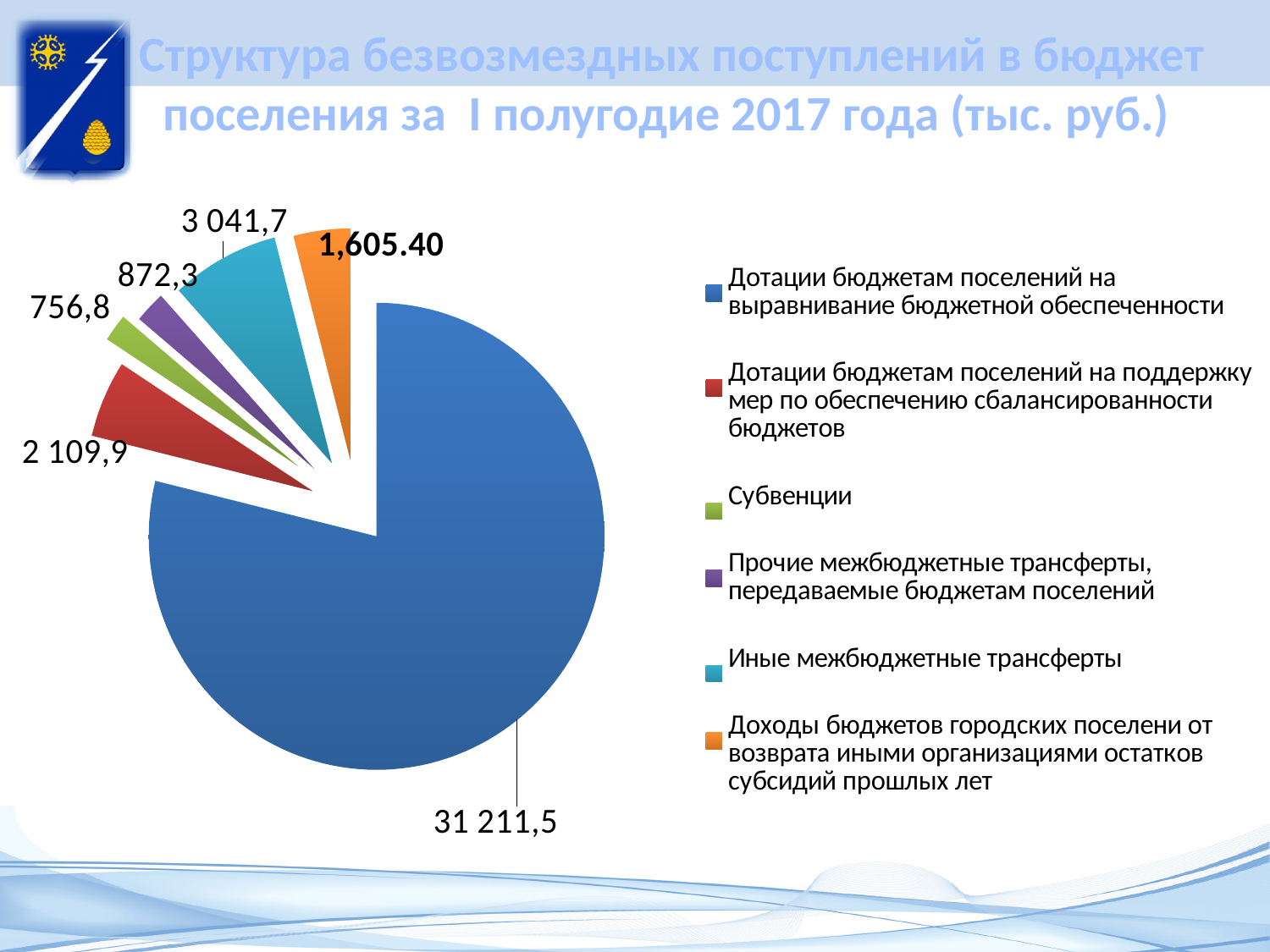
What is the value for «Дотации бюджетам поселений на выравнивание бюджетной обеспеченности»? 31 211,5 How many slices does the pie chart have? 6 Which category has the largest slice of the pie? Дотации бюджетам поселений на выравнивание бюджетной обеспеченности What is the value for «Иные межбюджетные трансферты»? 3 041,7 How many entries does the legend list? 6 What colour is the slice for «Прочие межбюджетные трансферты, передаваемые бюджетам поселений»? purple What is the value for «Субвенции»? 756,8 What is the difference between «Иные межбюджетные трансферты» (3 041,7) and «Дотации бюджетам поселений на поддержку мер по обеспечению сбалансированности бюджетов» (2 109,9)? 931,8 Which is larger: «Иные межбюджетные трансферты» or «Дотации бюджетам поселений на поддержку мер по обеспечению сбалансированности бюджетов»? Иные межбюджетные трансферты What is the value for «Доходы бюджетов городских поселени от возврата иными организациями остатков субсидий прошлых лет»? 1,605.40 What type of chart is shown on the slide? pie chart Which category has the smallest slice of the pie? Субвенции